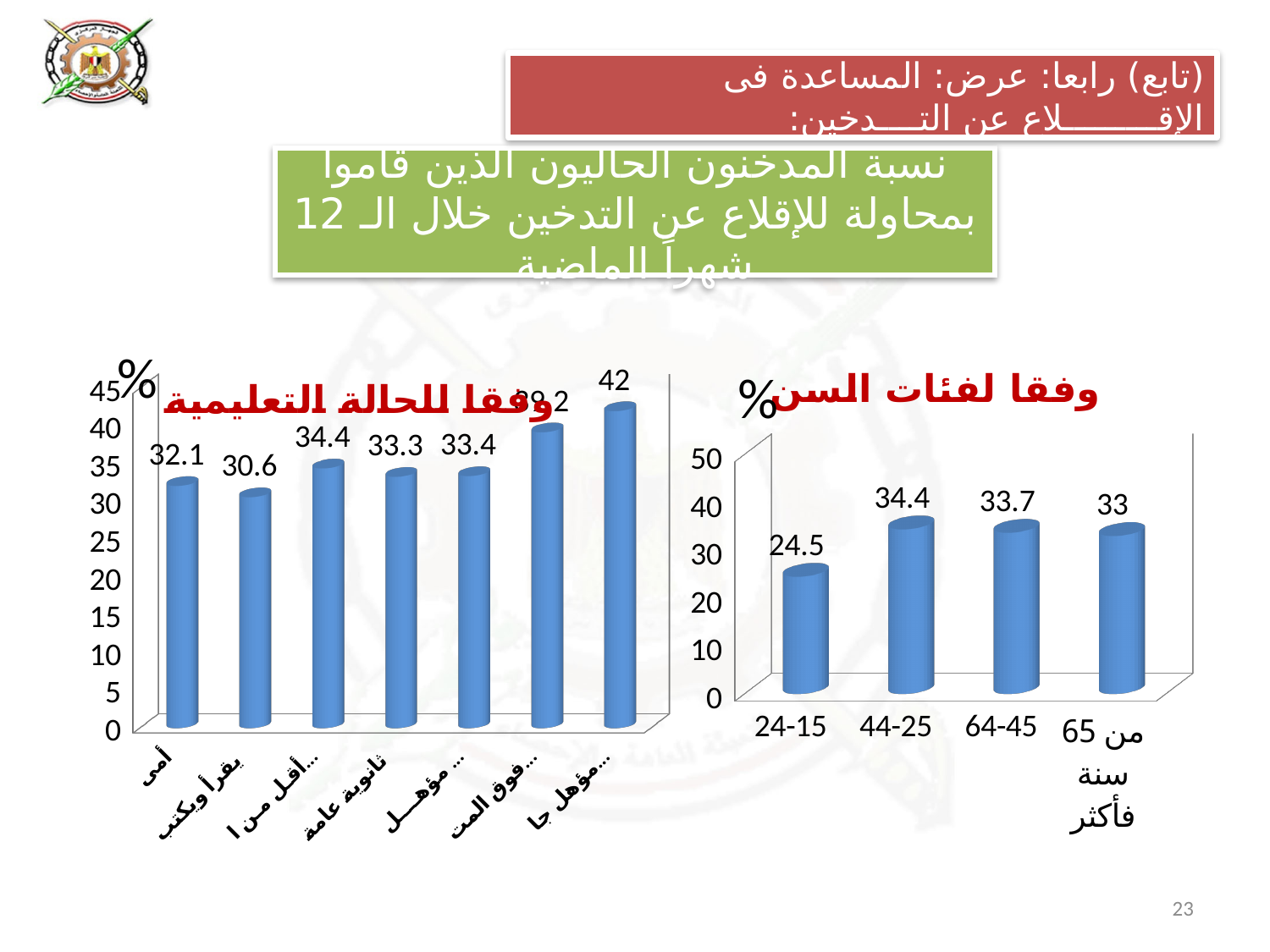
In the left chart (وفقا للحالة التعليمية), what is the value for أمي? 32.1 What type of chart is the right chart (وفقا لفئات السن)? Bar chart In the right chart (وفقا لفئات السن), what is the difference between the values for 25-44 and 15-24? 9.9 In the right chart (وفقا لفئات السن), what is the value for the 15-24 age group? 24.5 In the left chart (وفقا للحالة التعليمية), what is the highest value shown? 42 In the right chart (وفقا لفئات السن), which age group has the lowest value? 15-24 In the left chart (وفقا للحالة التعليمية), what is the value for يقرأ ويكتب? 30.6 In the right chart (وفقا لفئات السن), what is the value for the 25-44 age group? 34.4 In the right chart (وفقا لفئات السن), how many age groups are shown? 4 In the right chart (وفقا لفئات السن), which age group has the highest value? 25-44 In the left chart (وفقا للحالة التعليمية), which is larger, the value for أمي or the value for يقرأ ويكتب? أمي In the left chart (وفقا للحالة التعليمية), what is the value for ثانوية عامة? 33.3